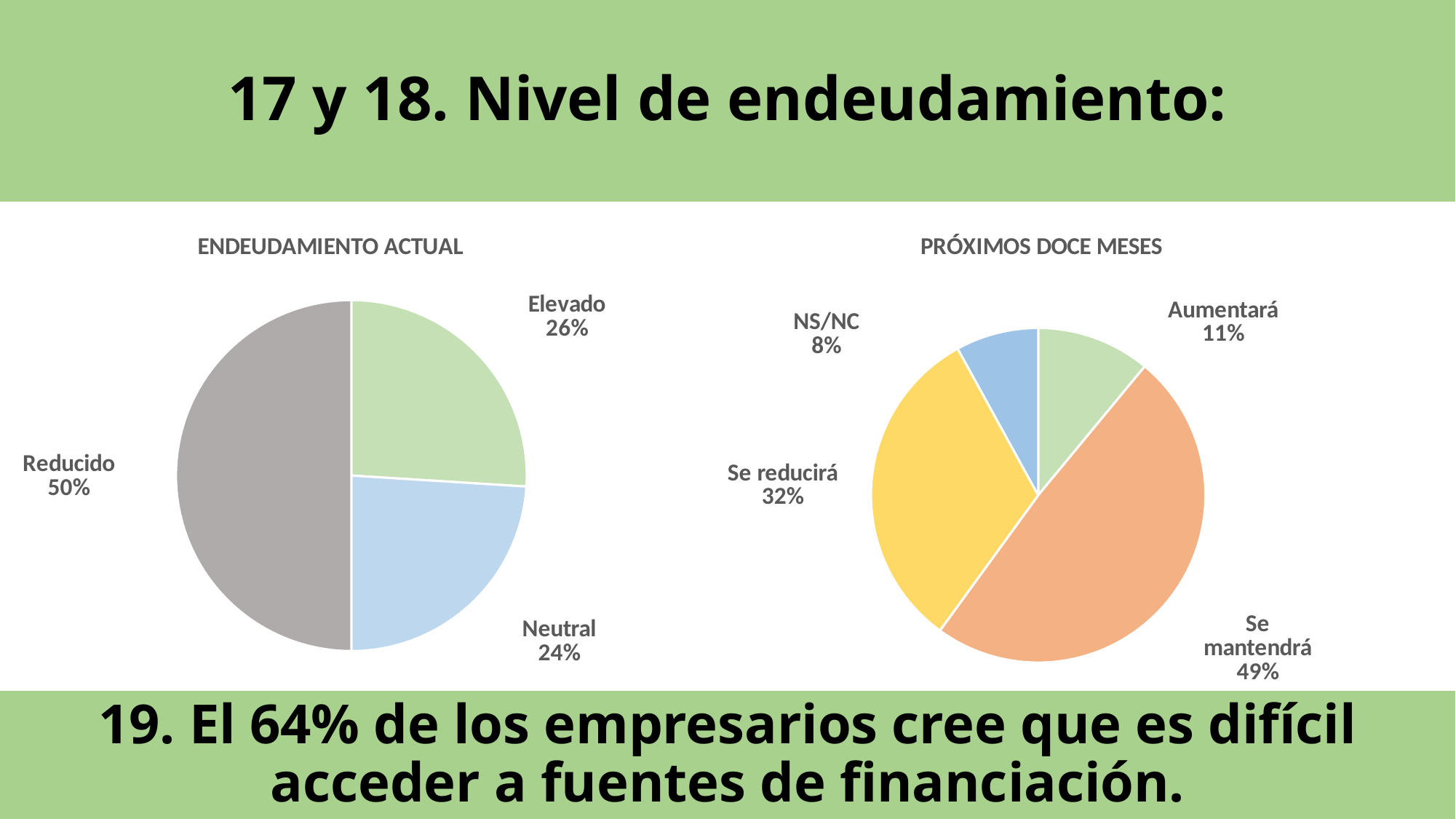
In the 'ENDEUDAMIENTO ACTUAL' chart, which category has the largest slice? Reducido In the 'PRÓXIMOS DOCE MESES' chart, what share is labelled for NS/NC? 8% In the 'PRÓXIMOS DOCE MESES' chart, how many slices does the pie have? 4 In the 'PRÓXIMOS DOCE MESES' chart, what share is labelled for Se mantendrá? 49% In the 'PRÓXIMOS DOCE MESES' chart, which is larger, Se reducirá or Aumentará? Se reducirá In the 'PRÓXIMOS DOCE MESES' chart, which category has the largest slice? Se mantendrá In the 'ENDEUDAMIENTO ACTUAL' chart, which category has the smallest slice? Neutral In the 'ENDEUDAMIENTO ACTUAL' chart, what share is labelled for Elevado? 26% In the 'ENDEUDAMIENTO ACTUAL' chart, what is the difference in percentage points between Reducido and Neutral? 26 What type of chart is used for 'PRÓXIMOS DOCE MESES'? Pie chart In the 'ENDEUDAMIENTO ACTUAL' chart, how many slices does the pie have? 3 In the 'ENDEUDAMIENTO ACTUAL' chart, what share is labelled for Reducido? 50%